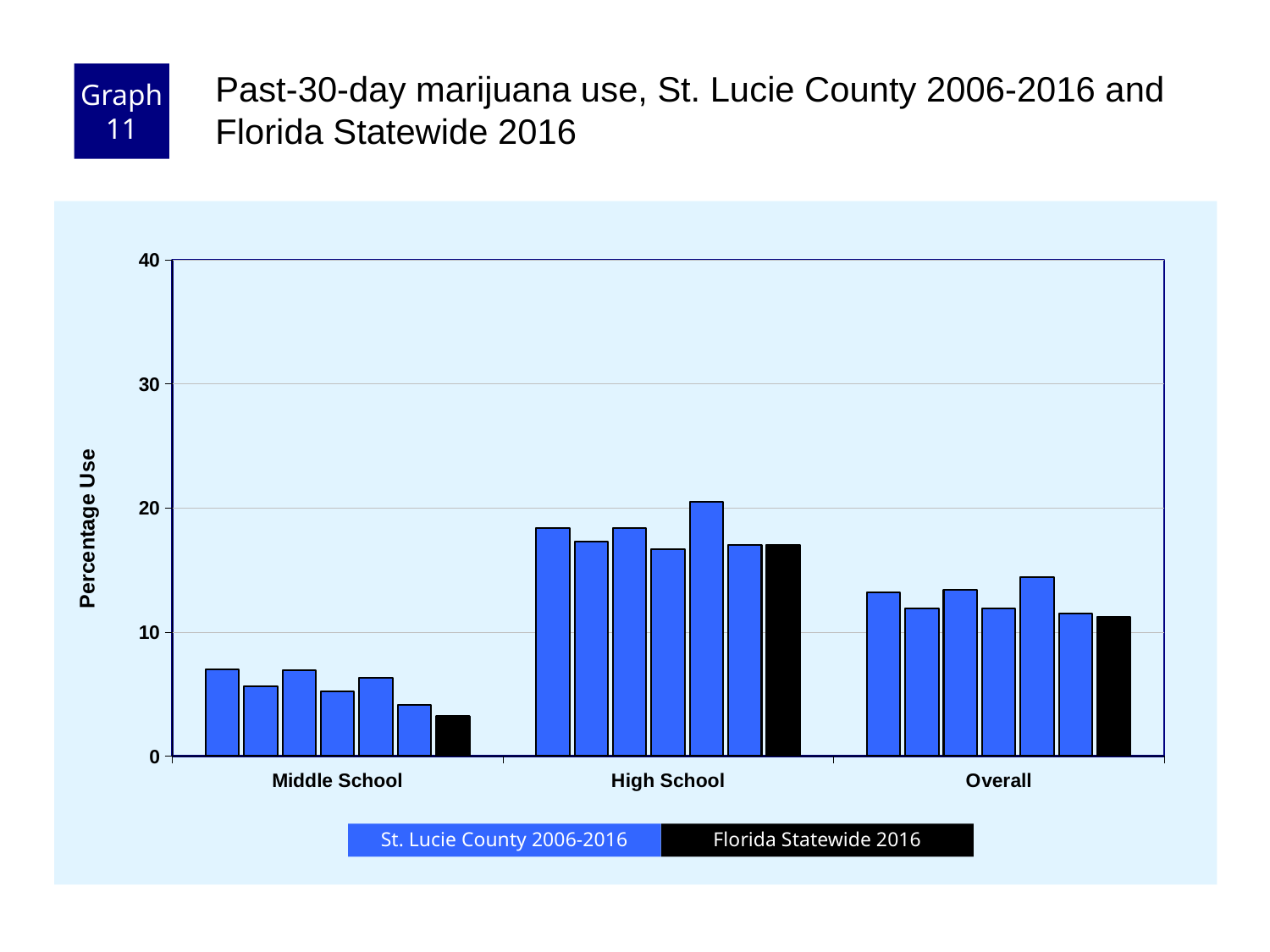
Is the Florida Statewide 2016 value for Middle School greater or less than 10? less Which colour represents Florida Statewide 2016 in the legend? black Is the Florida Statewide 2016 value for Overall greater or less than 10? greater How many categories are shown along the x axis? 3 Is the Florida Statewide 2016 value for High School greater or less than 20? less What kind of chart is shown on the slide? bar chart How many series does the legend list? 2 Which category has the lowest bars overall? Middle School Which category has the highest bars overall? High School Which is larger, the Florida Statewide 2016 value for High School or for Overall? High School What is the label on the y axis? Percentage Use